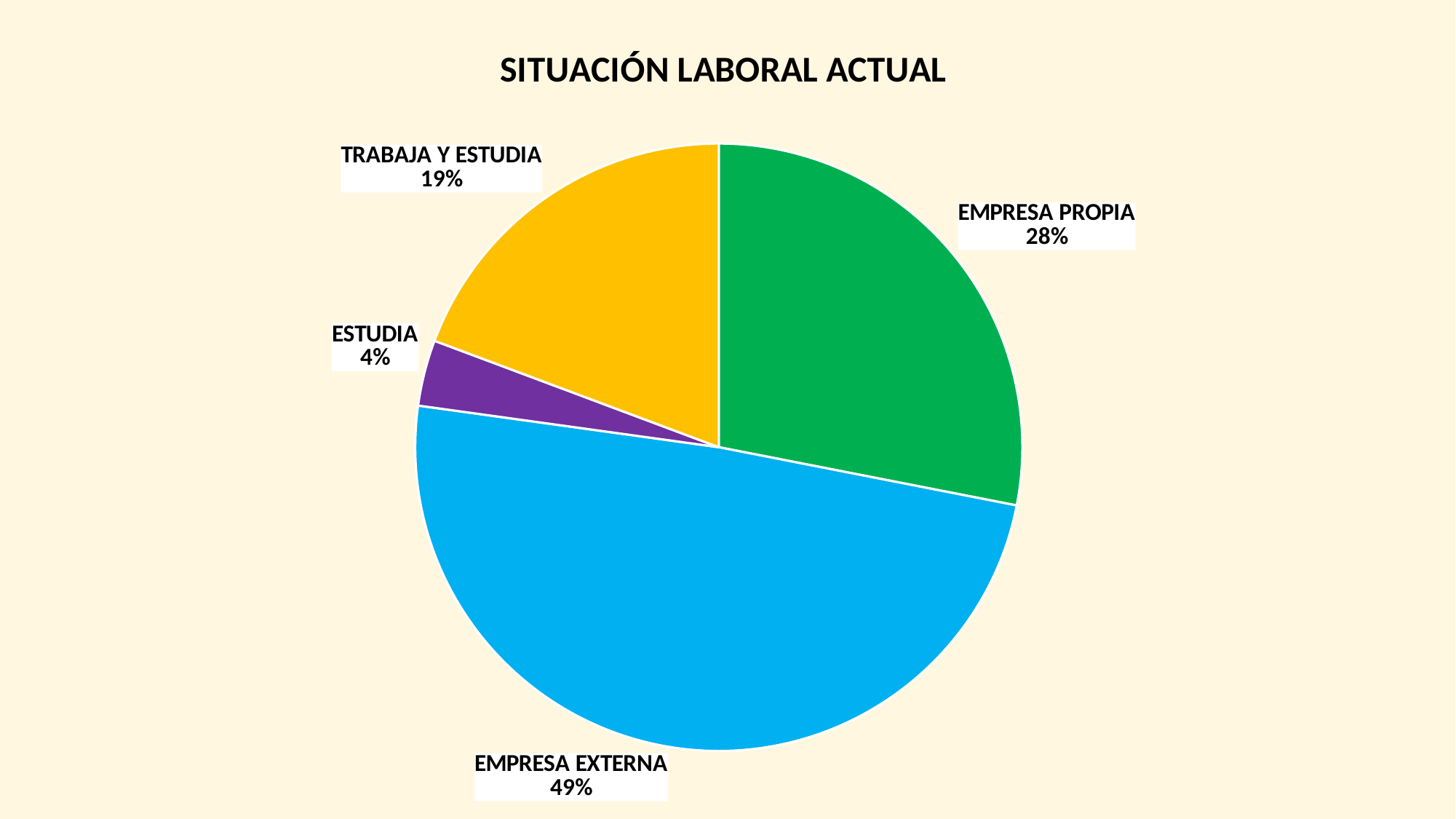
What colour is the EMPRESA EXTERNA slice? blue What percentage is shown for EMPRESA PROPIA? 28% Which category has the smallest share of the pie? ESTUDIA Which category has the largest share of the pie? EMPRESA EXTERNA What percentage is shown for EMPRESA EXTERNA? 49% What percentage is shown for ESTUDIA? 4% What percentage is shown for TRABAJA Y ESTUDIA? 19% What type of chart is shown on the slide? pie chart How many slices does the pie chart have? 4 What is the difference in percentage points between EMPRESA EXTERNA and EMPRESA PROPIA? 21 What is the title of the chart? SITUACIÓN LABORAL ACTUAL Which is larger, the share for EMPRESA PROPIA or the share for TRABAJA Y ESTUDIA? EMPRESA PROPIA